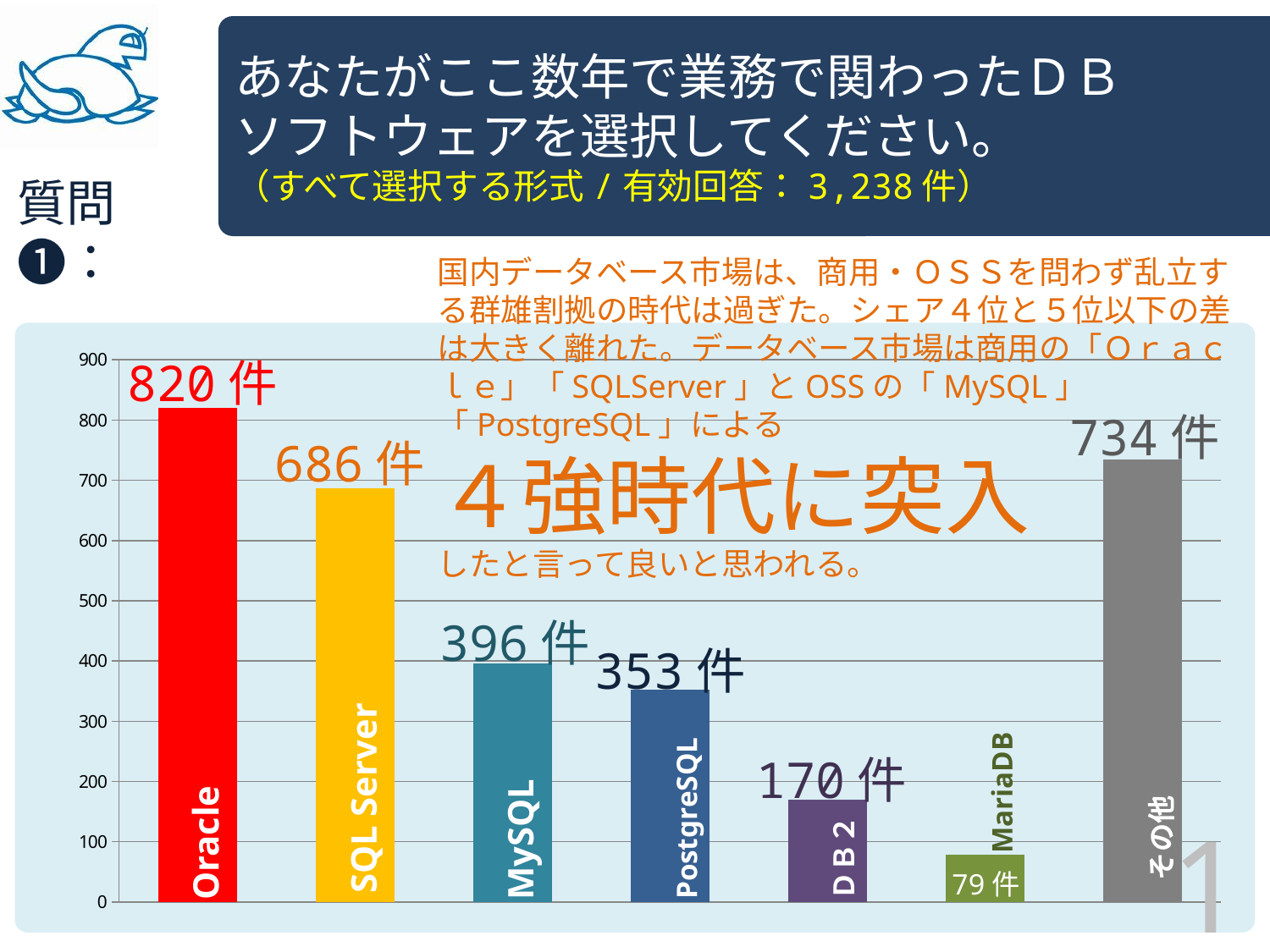
What is the difference between the values for Oracle and SQL Server? 134 件 Which category has the highest value? Oracle What is the value for SQL Server? 686 件 Which category has the lowest value? MariaDB How many categories are shown in the chart? 7 Is the value for DB2 greater or less than 200? less What is the value for Oracle? 820 件 Which is larger, the value for その他 or the value for SQL Server? その他 What is the difference between the values for MySQL and PostgreSQL? 43 件 What kind of chart is shown on the slide? bar chart What is the value for MySQL? 396 件 What is the value for MariaDB? 79 件